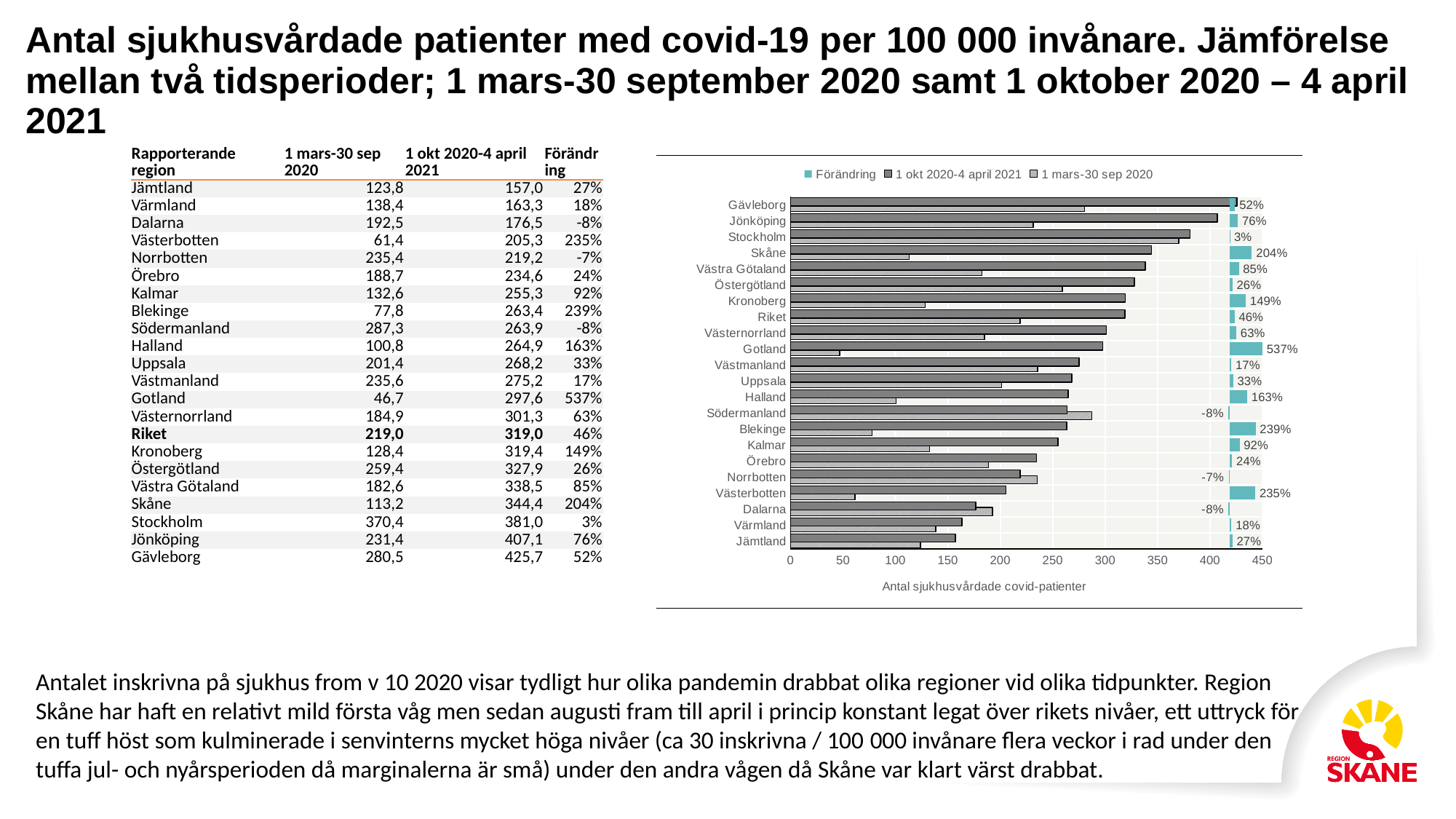
What is the Förändring value shown for Riket? 46% In the series 1 mars-30 sep 2020, which is larger: Stockholm or Skåne? Stockholm What is the title of the chart's horizontal axis? Antal sjukhusvårdade covid-patienter Which region has the highest Förändring value? Gotland Is the value for Gävleborg in the series 1 okt 2020-4 april 2021 greater or less than 400? greater What is the Förändring value shown for Norrbotten? -7% What is the Förändring value shown for Skåne? 204% What is the Förändring value shown for Gotland? 537% Is the value for Gotland in the series 1 mars-30 sep 2020 greater or less than 100? less What kind of chart is shown on the slide? bar chart How many series does the chart's legend list? 3 How many regions (categories) are plotted on the chart? 22